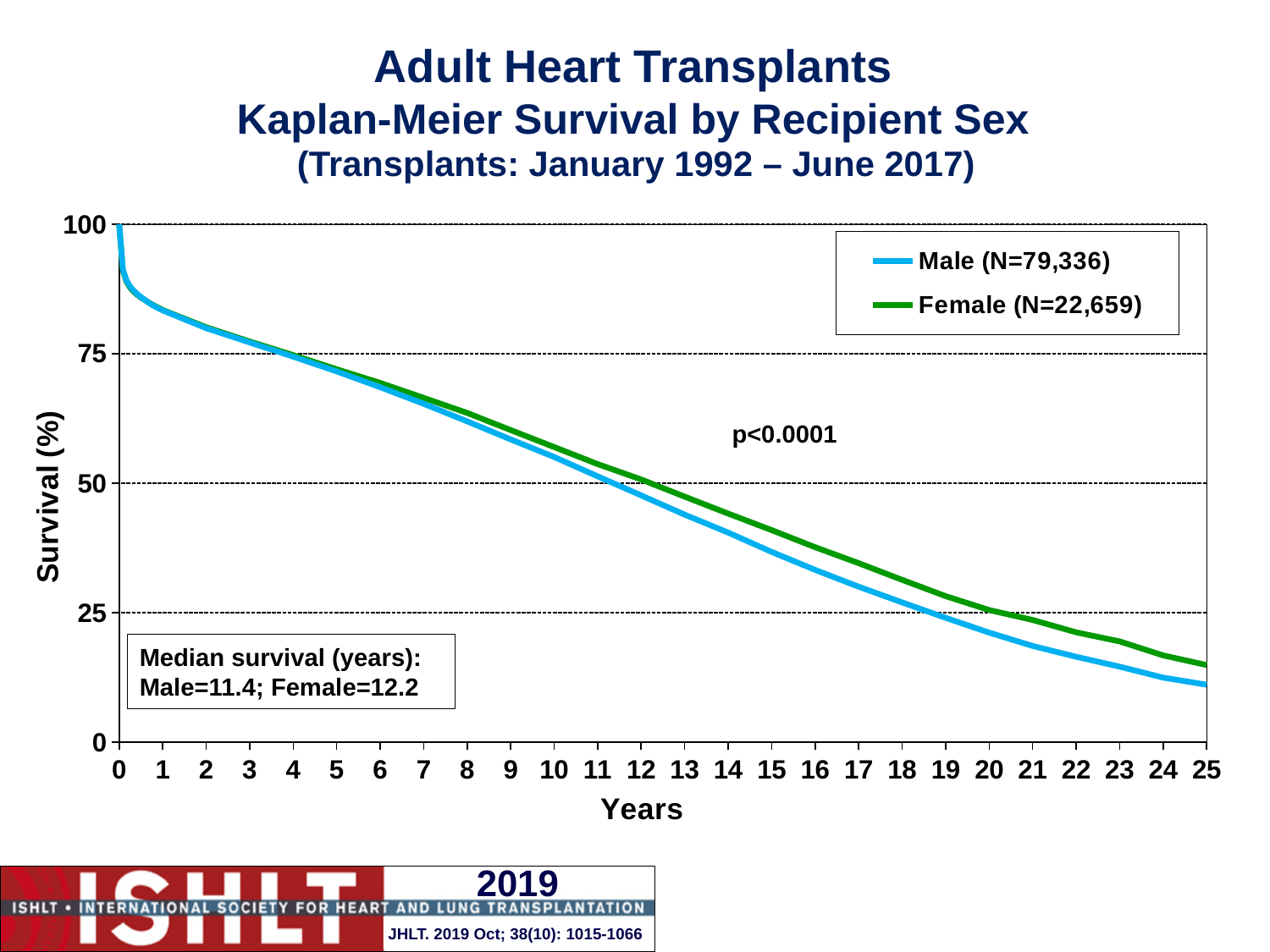
How many series does the legend list? 2 What p-value is shown on the chart? p<0.0001 What is the difference in median survival (years) between female and male recipients? 0.8 What is the number of male recipients (N) shown in the legend? 79,336 Is the survival for male recipients at 20 years greater or less than 25? less Do the survival curves rise or fall as years increase? Fall Is the survival for female recipients at 10 years greater or less than 50? greater Which recipient sex has the longer median survival? Female What is the number of female recipients (N) shown in the legend? 22,659 What is the median survival in years for female recipients? 12.2 What is the median survival in years for male recipients? 11.4 What kind of chart is shown on the slide? Line chart